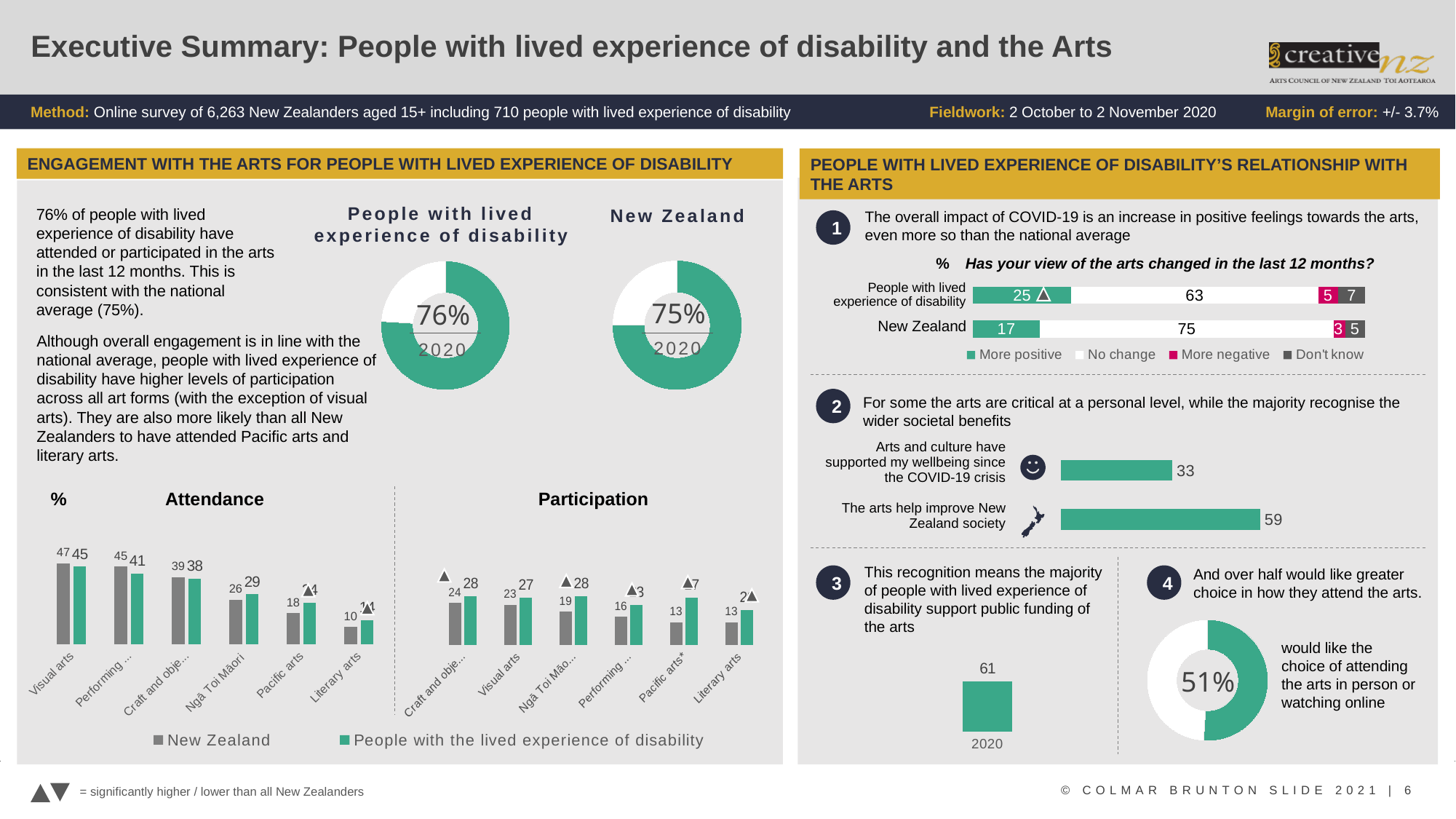
In the Participation chart, what is the New Zealand value for Craft and objects? 24 What percentage is shown in the 'People with lived experience of disability' donut chart? 76% In the Attendance chart, which category has the highest New Zealand value? Visual arts In the Attendance chart, what is the New Zealand value for Visual arts? 47 In the chart under point 2, what is the value for 'The arts help improve New Zealand society'? 59 In the 'Has your view of the arts changed in the last 12 months?' chart, what percentage of people with lived experience of disability said 'More positive'? 25 In the Attendance chart, what is the value for people with the lived experience of disability for Ngā Toi Māori? 29 In the 'Has your view of the arts changed in the last 12 months?' chart, what percentage of New Zealand respondents said 'No change'? 75 In the Participation chart, which is larger for Visual arts: the New Zealand value or the value for people with the lived experience of disability? People with the lived experience of disability In the 'Has your view of the arts changed in the last 12 months?' chart, how many series does the legend list? 4 In the 'Has your view of the arts changed in the last 12 months?' chart, what is the difference between the 'More positive' values for people with lived experience of disability and New Zealand? 8 What value is shown on the single bar for 2020 under point 3 about support for public funding of the arts? 61